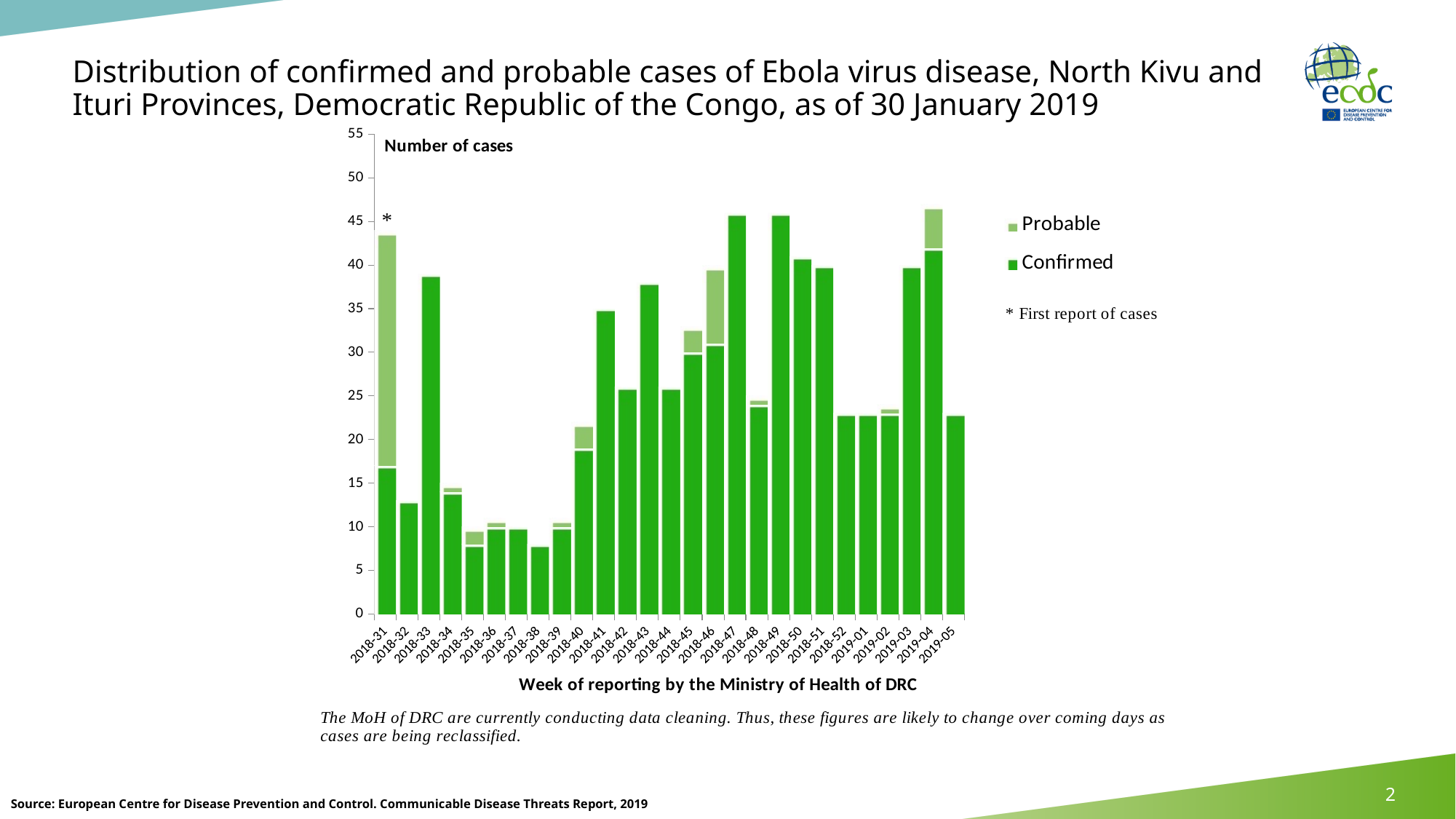
Do the number of cases generally rise or fall from week 2018-38 to week 2018-47? rise Is the total number of cases for week 2018-31 greater or less than 40? greater What is the title of the x axis? Week of reporting by the Ministry of Health of DRC Which week has more confirmed cases, 2018-41 or 2018-42? 2018-41 According to the note on the slide, what does the asterisk above the first bar indicate? First report of cases Is the number of cases for week 2018-38 greater or less than 10? less How many reporting weeks are shown on the x axis? 27 What kind of chart is shown on the slide? Stacked bar chart Is the number of confirmed cases for week 2019-05 greater or less than 25? less How many series does the legend list? 2 Which week has more confirmed cases, 2018-32 or 2018-33? 2018-33